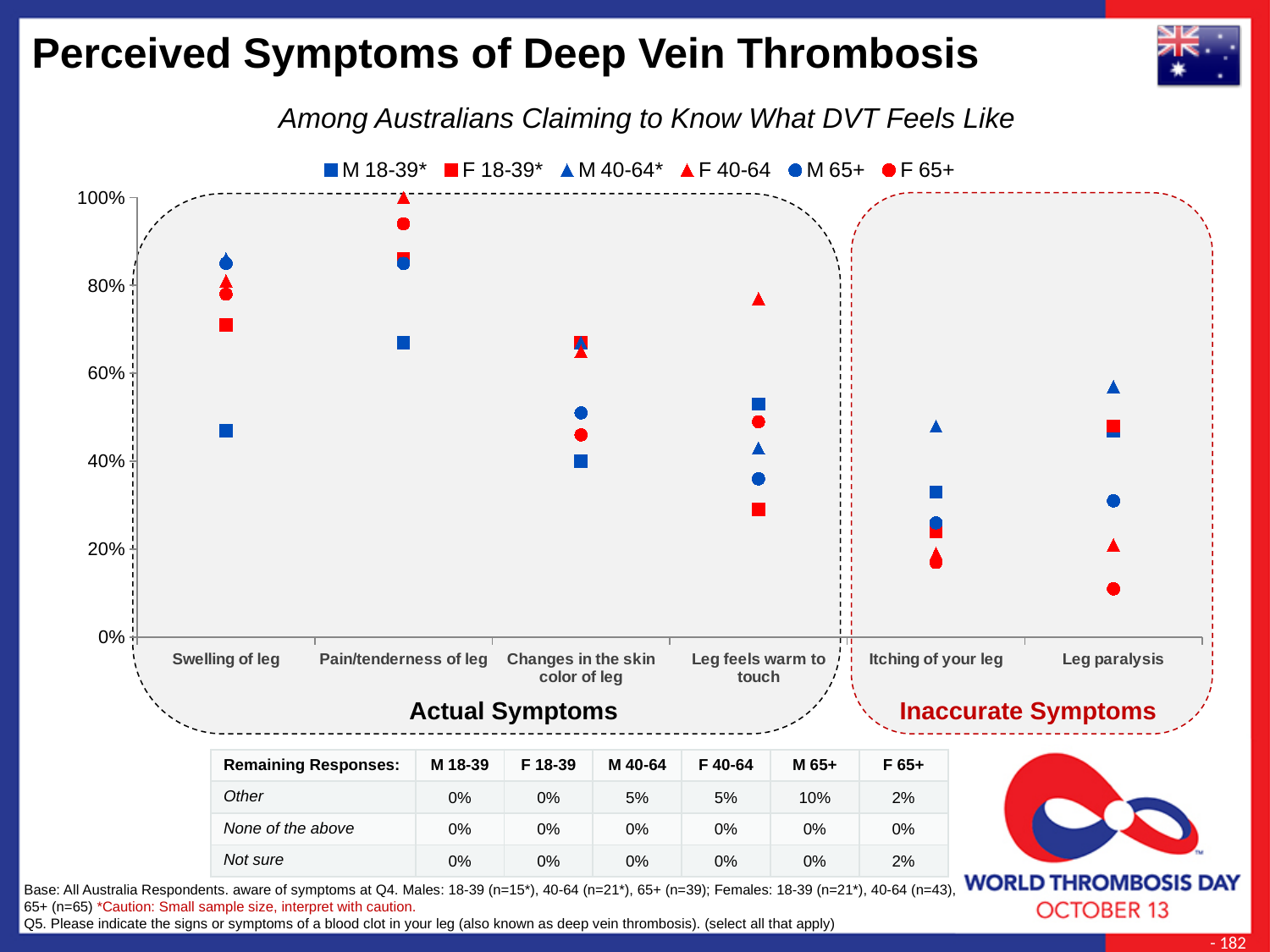
Is the value for F 40-64 on Leg feels warm to touch greater or less than 60%? greater What kind of chart is shown on the slide? Scatter (dot) plot Which two symptoms are grouped under the 'Inaccurate Symptoms' label on the chart? Itching of your leg and Leg paralysis Is the value for M 18-39 on Itching of your leg greater or less than 40%? less Is the value for M 18-39 on Swelling of leg greater or less than 60%? less Which symptom has the highest value for the F 40-64 series? Pain/tenderness of leg How many series does the chart legend list? 6 For Swelling of leg, which is larger: the value for M 18-39 or the value for F 18-39? F 18-39 How many symptom categories are shown along the x axis of the chart? 6 Which symptom has the lowest value for the F 65+ series? Leg paralysis For Leg paralysis, which is larger: the value for M 40-64 or the value for F 65+? M 40-64